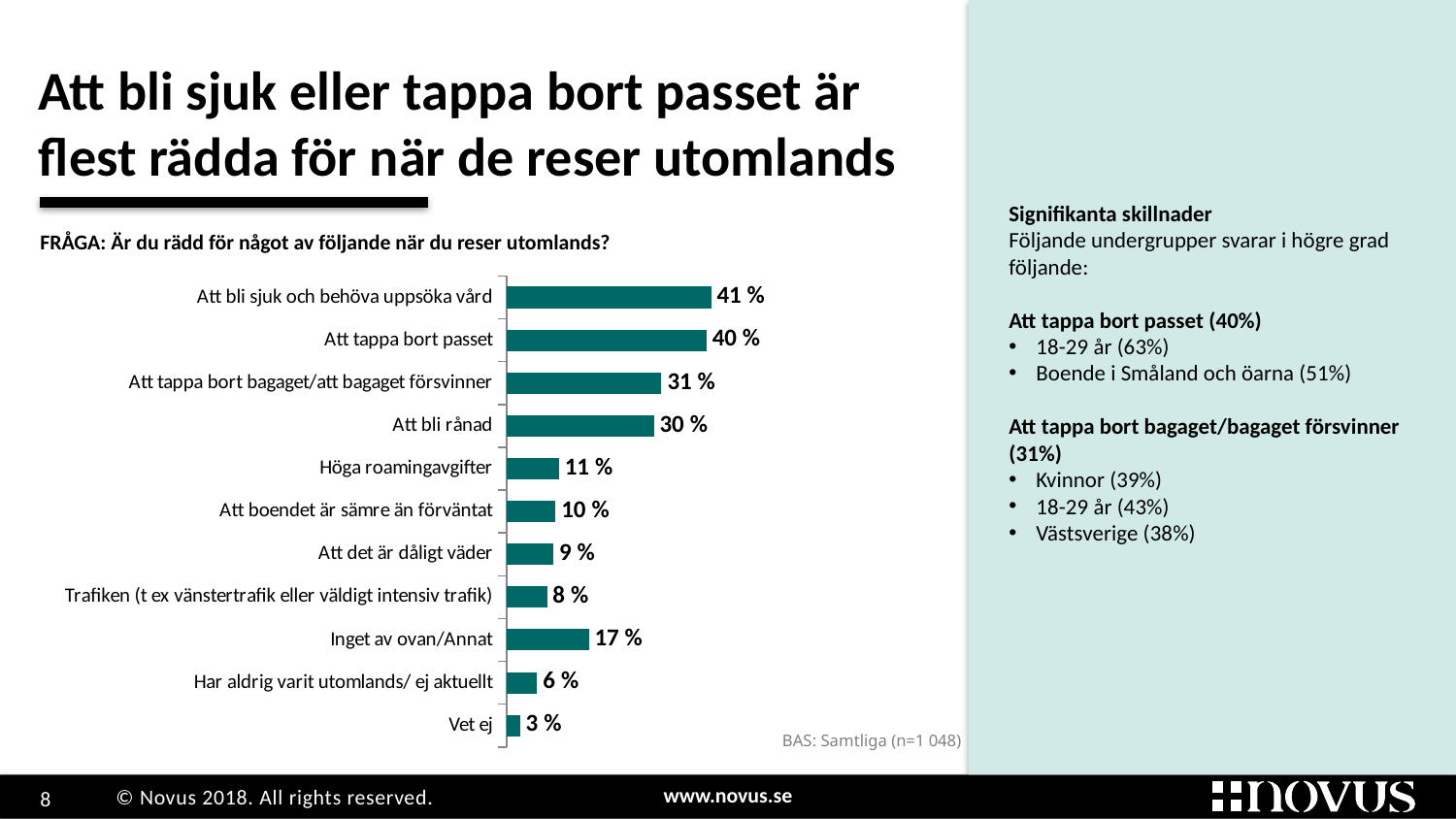
What is the base (n) stated below the chart? n=1 048 What is the difference between "Att bli sjuk och behöva uppsöka vård" and "Vet ej"? 38 % How many categories are shown in the chart? 11 Which category has the lowest value? Vet ej What kind of chart is shown on the slide? Bar chart Which is larger: "Att det är dåligt väder" or "Inget av ovan/Annat"? Inget av ovan/Annat What is the value for "Att tappa bort passet"? 40 % Which category has the highest value? Att bli sjuk och behöva uppsöka vård Which is larger: "Har aldrig varit utomlands/ ej aktuellt" or "Trafiken (t ex vänstertrafik eller väldigt intensiv trafik)"? Trafiken (t ex vänstertrafik eller väldigt intensiv trafik) What is the value for "Inget av ovan/Annat"? 17 % What is the difference between "Att tappa bort bagaget/att bagaget försvinner" and "Att bli rånad"? 1 % What is the value for "Höga roamingavgifter"? 11 %